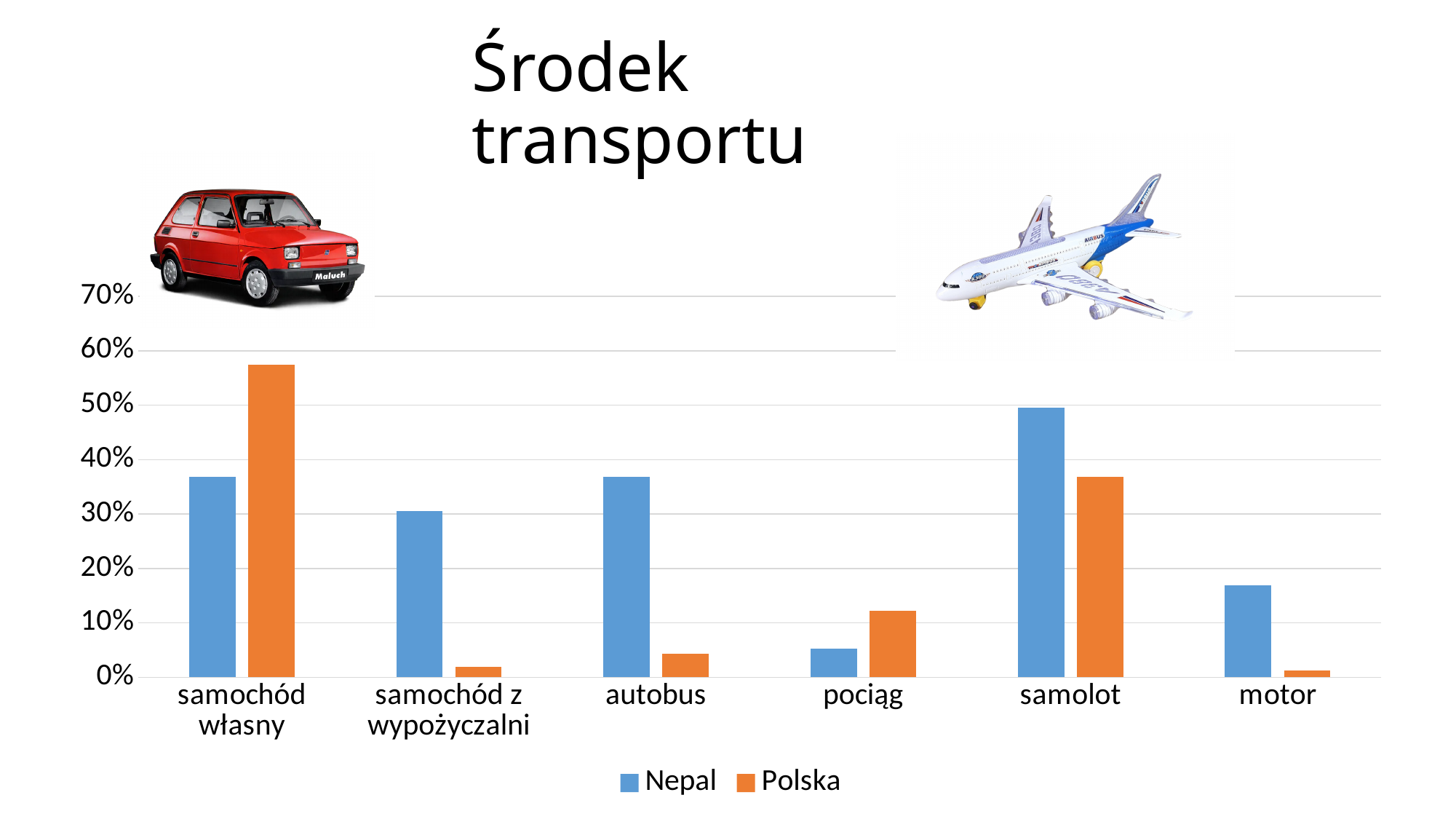
Is the value for Polska in samochód własny greater or less than 50%? greater Which category has the highest value for Polska? samochód własny What is the title of the chart? Środek transportu How many series does the legend list? 2 What kind of chart is shown on the slide? bar chart Which category has the lowest value for Nepal? pociąg Is the value for Nepal in pociąg greater or less than 10%? less How many categories are shown on the x axis? 6 Is the value for Polska in pociąg greater or less than 10%? greater Which category has the highest value for Nepal? samolot For autobus, which series has the larger value, Nepal or Polska? Nepal